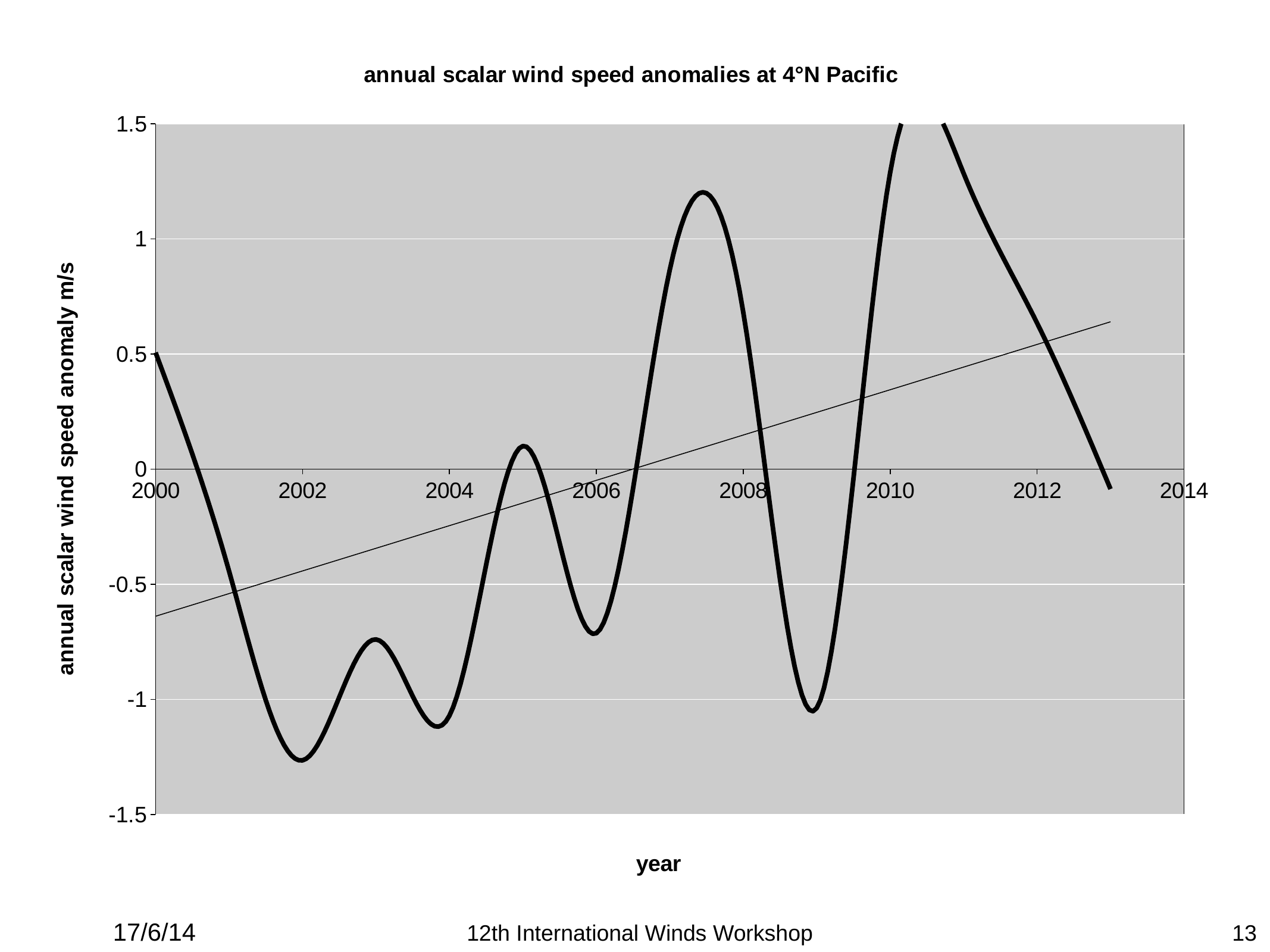
Is the wind speed anomaly value for 2010 greater or less than 1? greater Around which year does the thick curve reach its lowest value? 2002 Is the wind speed anomaly value for 2000 greater or less than 0? greater What kind of chart is shown on the slide? line chart Is the wind speed anomaly value for 2004 greater or less than -1? less Which year has a larger wind speed anomaly, 2002 or 2006? 2006 What is the label of the vertical axis? annual scalar wind speed anomaly m/s Does the thin straight trend line rise or fall from 2000 to 2014? rise What is the title of the chart? annual scalar wind speed anomalies at 4°N Pacific